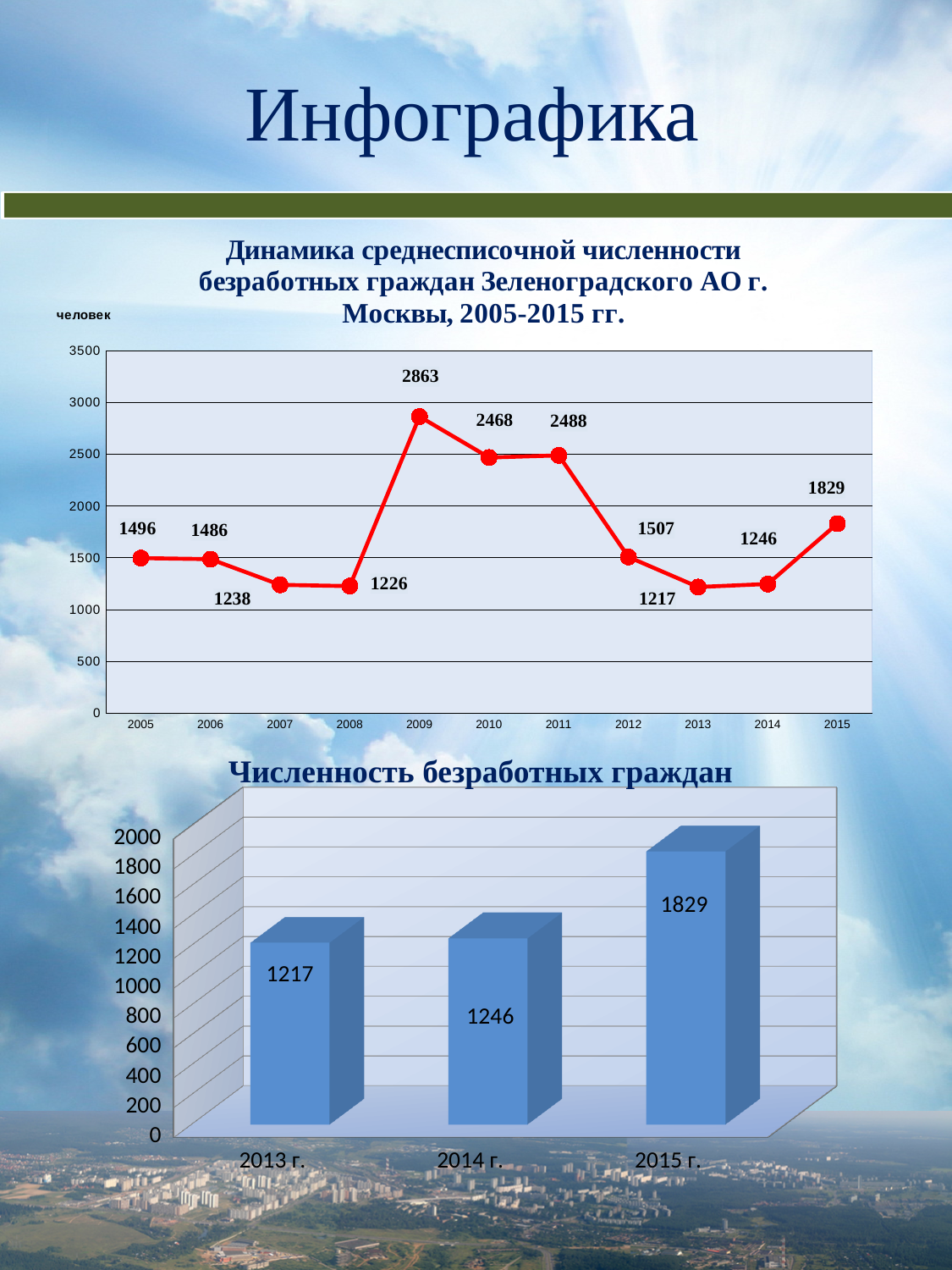
In the top line chart, what was the value for 2009? 2863 In the top line chart, which year has the lowest value? 2013 What type of chart is the top chart on the slide? line chart In the top line chart, what is the difference between the values for 2011 and 2010? 20 In the top line chart, which year has the highest value? 2009 In the bottom chart titled 'Численность безработных граждан', what is the difference between the values for 2015 г. and 2013 г.? 612 In the bottom chart titled 'Численность безработных граждан', what is the value for 2014 г.? 1246 What type of chart is the bottom chart on the slide? bar chart How many data points are plotted in the top line chart? 11 In the top line chart, did the value rise or fall from 2008 to 2009? rise In the top line chart, what was the value for 2005? 1496 In the top line chart, which is larger: the value for 2012 or the value for 2006? 2012